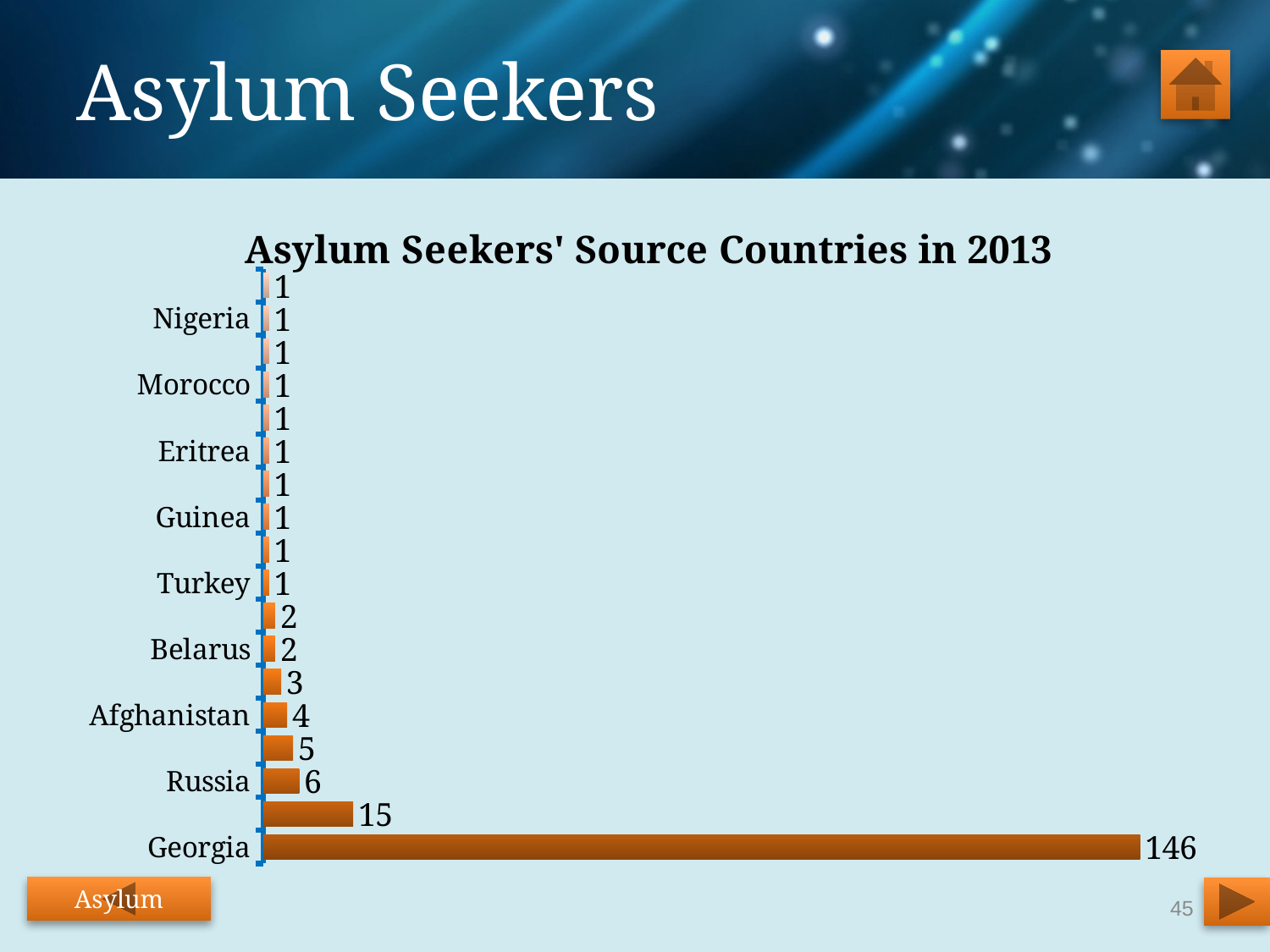
What is the difference between the values for Russia and Afghanistan? 2 Which country has the highest value? Georgia What kind of chart is shown? Bar chart What is the value for Afghanistan? 4 How many bars are plotted in the chart? 18 What is the value for Georgia? 146 Which is larger, the value for Russia or the value for Belarus? Russia What is the difference between the values for Georgia and Russia? 140 What is the value for Belarus? 2 What is the value for Turkey? 1 What is the title of the chart? Asylum Seekers' Source Countries in 2013 What is the value for Russia? 6